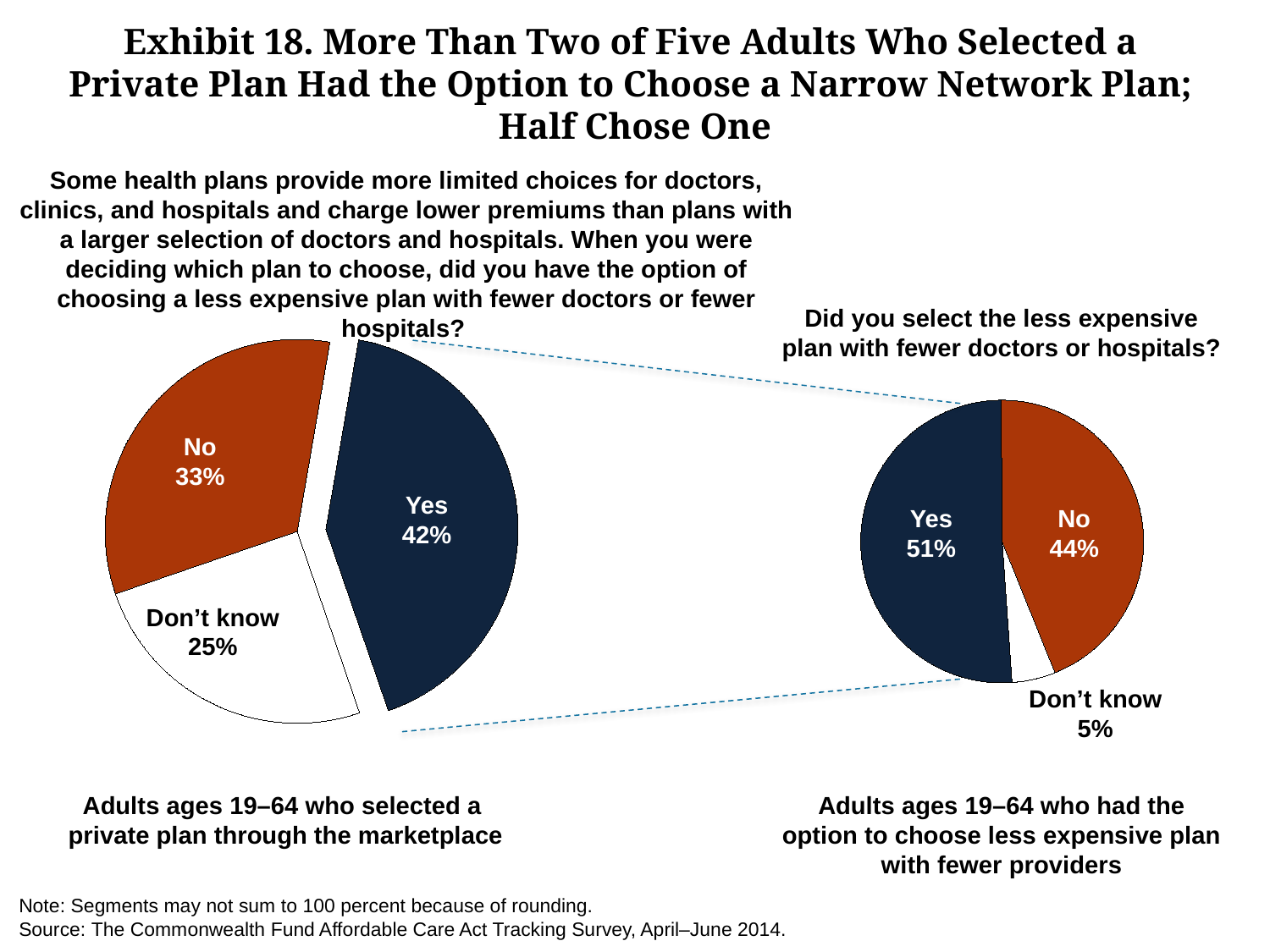
What type of chart is used on this slide? Pie chart In the right pie chart, which response has the smallest share? Don't know In the left pie chart, which is larger: the No share or the Don't know share? No How many segments does the right pie chart have? 3 In the left pie chart (adults who selected a private plan through the marketplace), what share answered Don't know? 25% In the left pie chart, what is the difference between the Yes share and the No share? 9 percentage points In the right pie chart, what is the difference between the Yes share and the No share? 7 percentage points In the right pie chart (adults who had the option to choose a less expensive plan), what share answered No? 44% In the left pie chart (adults who selected a private plan through the marketplace), what share answered Yes? 42% In the right pie chart, what colour is the Yes segment? Dark navy blue In the right pie chart (adults who had the option to choose a less expensive plan), what share answered Don't know? 5% In the left pie chart, which response has the largest share? Yes